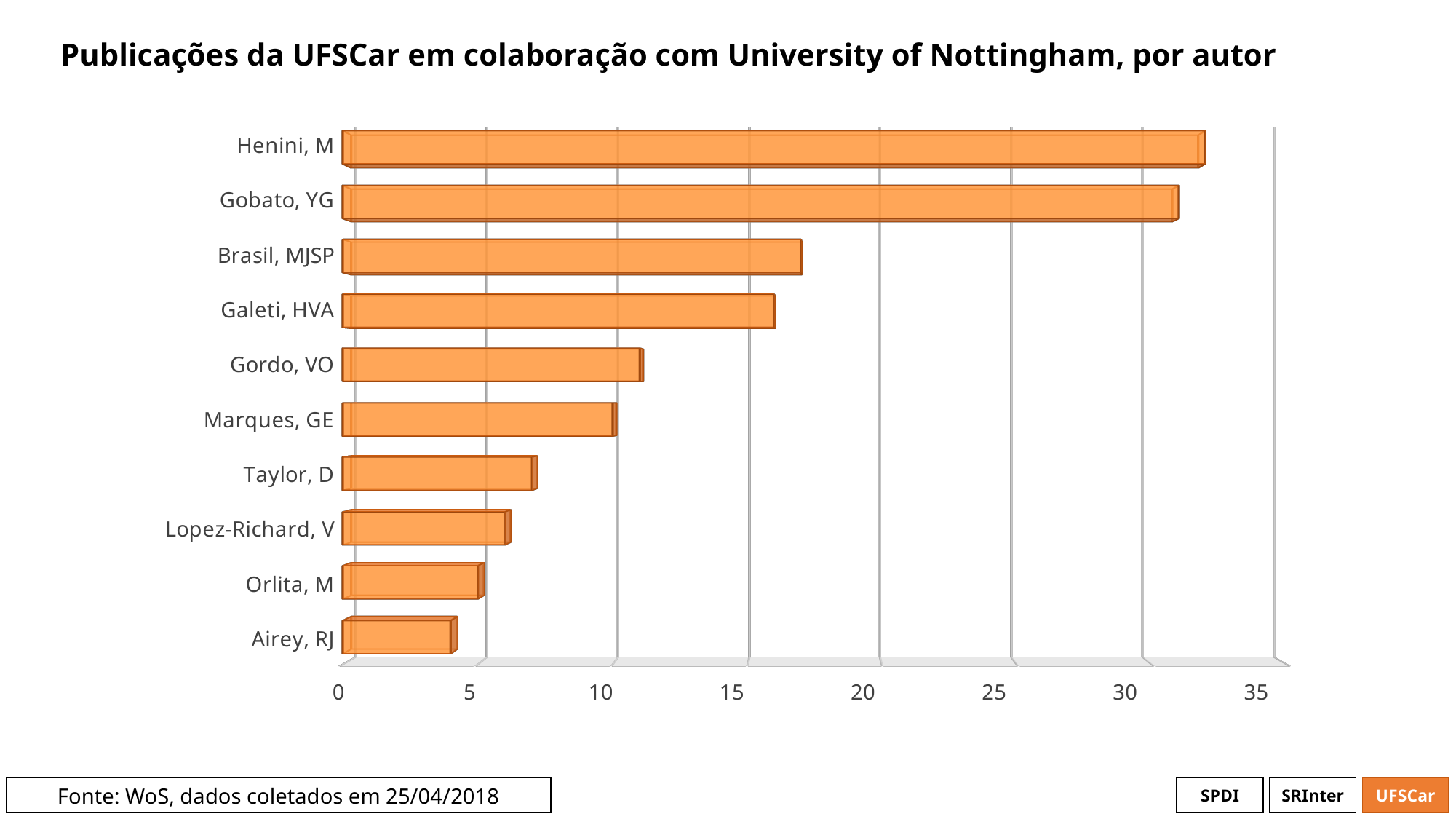
How many authors are listed on the chart? 10 Is the value for Taylor, D greater or less than 10? less Which has more publications, Brasil, MJSP or Gordo, VO? Brasil, MJSP Which author has the lowest number of publications? Airey, RJ Is the value for Airey, RJ greater or less than 5? less What is the title of the chart? Publicações da UFSCar em colaboração com University of Nottingham, por autor Is the value for Brasil, MJSP greater or less than 15? greater What kind of chart is shown on the slide? Bar chart Which has more publications, Lopez-Richard, V or Marques, GE? Marques, GE Which author has the highest number of publications? Henini, M